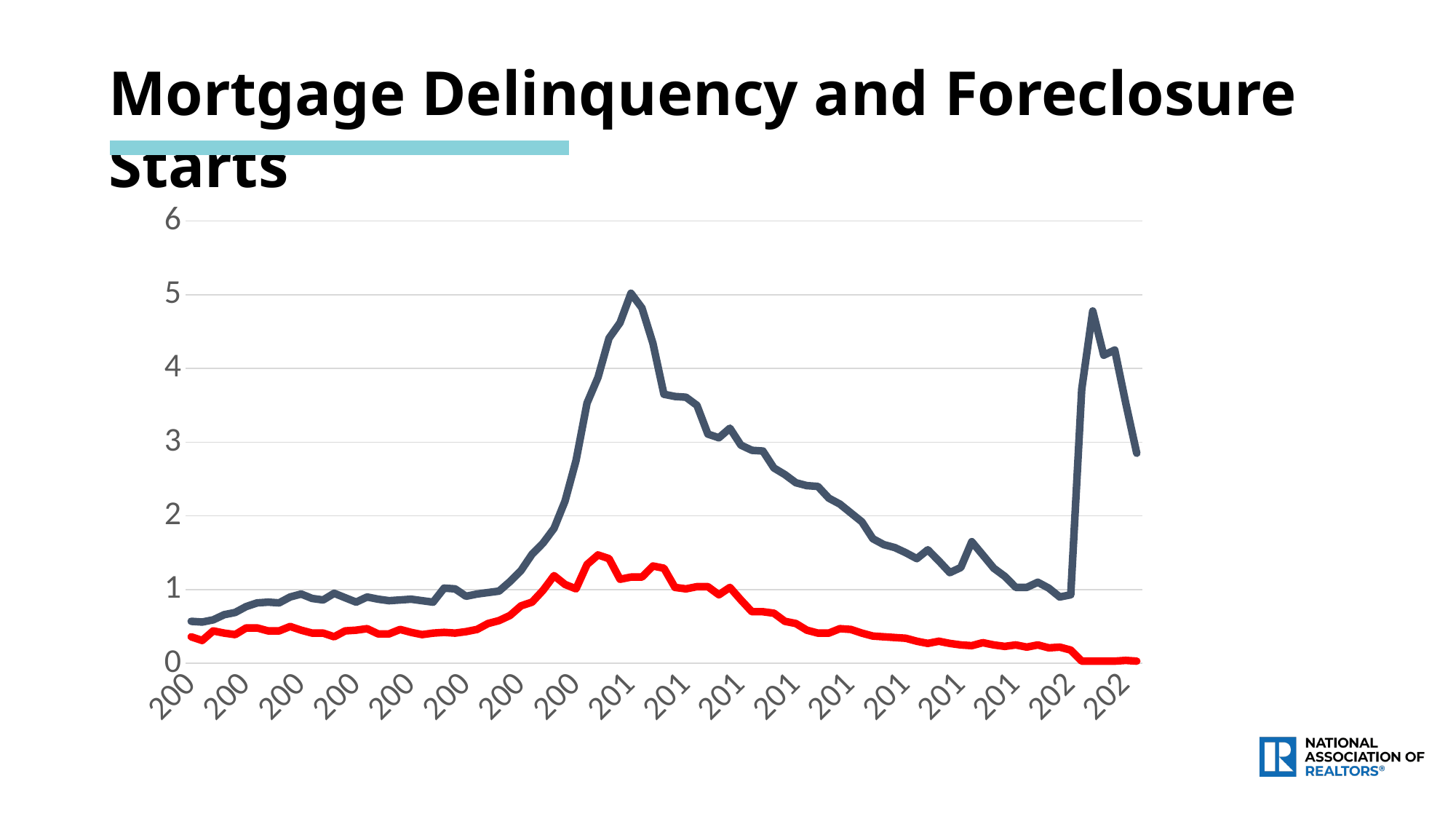
Is the final value of the dark blue line at the right end of the chart greater or less than 2? greater What is the highest value shown on the vertical axis? 6 Is the value of the dark blue line at the start of the x axis greater or less than 1? less Which line is lower across the whole chart, the dark blue line or the red line? the red line Is the final value of the red line at the right end of the chart greater or less than 1? less What kind of chart is shown on the slide? line chart How many lines are plotted on the chart? 2 What is the title of the chart on the slide? Mortgage Delinquency and Foreclosure Starts Does the red line rise or fall over the last third of the x axis? fall Which line reaches a higher peak, the dark blue line or the red line? the dark blue line